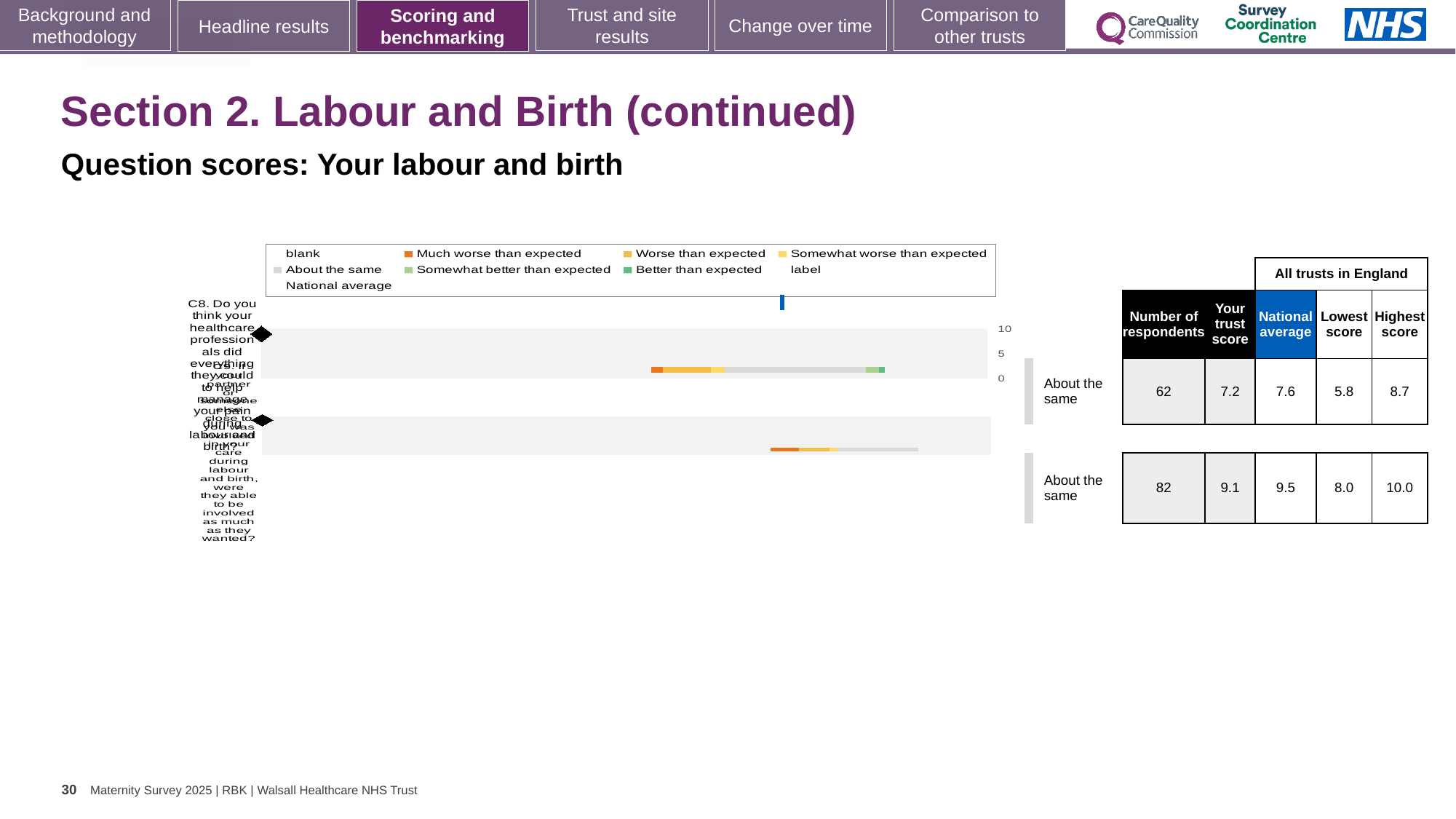
What is the number of respondents for the top question row (C8)? 62 For the top question row (C8), what is the difference between the highest score and the lowest score? 2.9 What is the trust score for the bottom question row? 9.1 Which question row has the larger number of respondents? The bottom row (82) What is the highest score across all trusts in England for the bottom question row? 10.0 How many question rows (bars) are plotted in the chart? 2 What benchmark category is shown for both question rows? About the same For the bottom question row, how much higher is the national average than the trust score? 0.4 What colour does the legend use for 'Much worse than expected'? Orange What kind of chart is shown on the slide? Bar chart For the top question row (C8), which is larger: the trust score or the national average? National average What is the national average for the top question row (C8)? 7.6